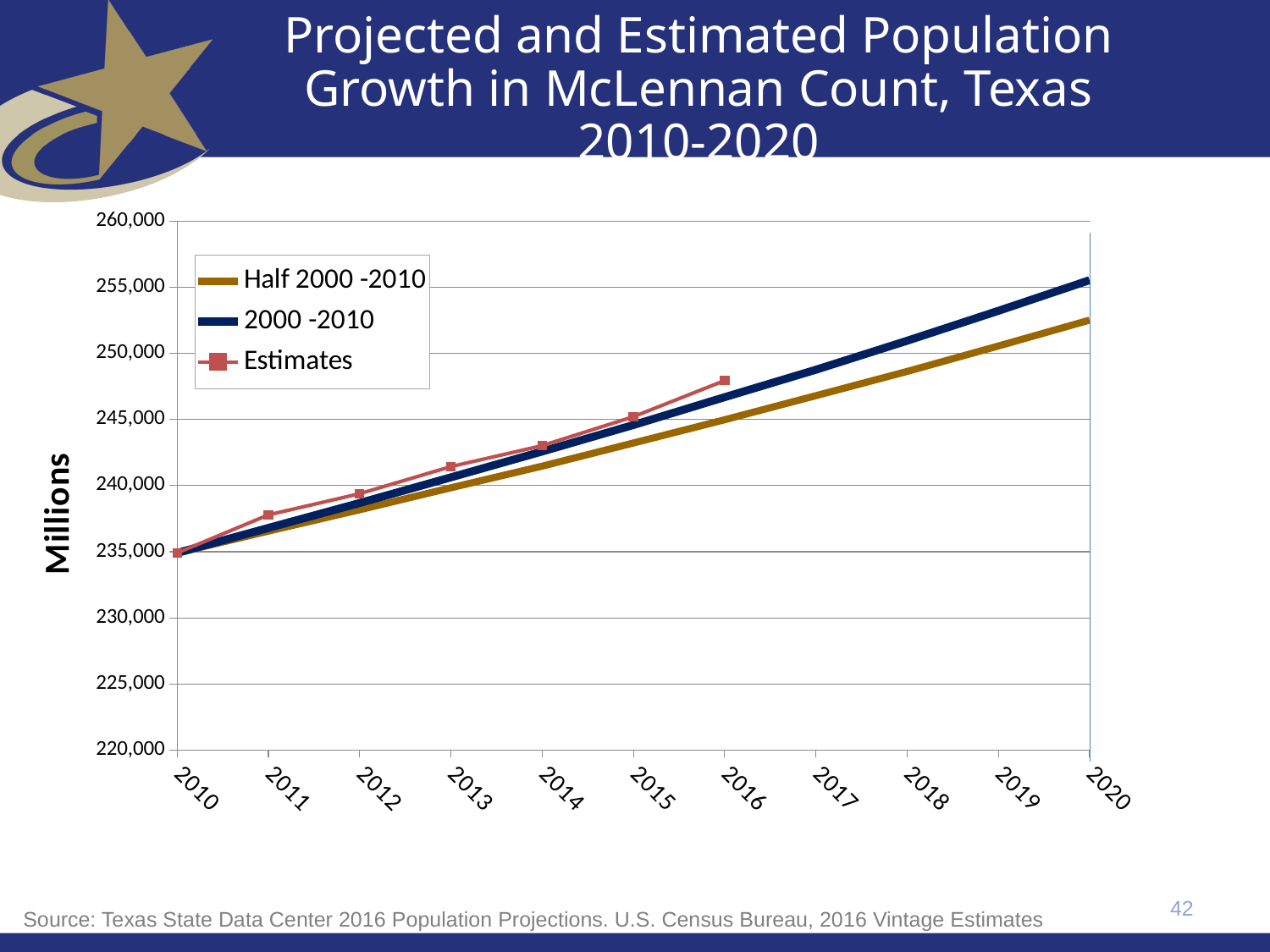
Is the Half 2000 -2010 value for 2020 greater or less than 255,000? less What kind of chart is shown on the slide? line chart What is the label on the y axis of the chart? Millions Which series has the higher value in 2020, 2000 -2010 or Half 2000 -2010? 2000 -2010 Which series has the higher value in 2016, Estimates or Half 2000 -2010? Estimates How many series does the legend list? 3 Is the 2000 -2010 value for 2020 greater or less than 250,000? greater Is the Estimates value for 2016 greater or less than 245,000? greater How many data points does the Estimates series have? 7 How many years are labelled along the x axis? 11 Do the values of the 2000 -2010 series rise or fall from 2010 to 2020? rise